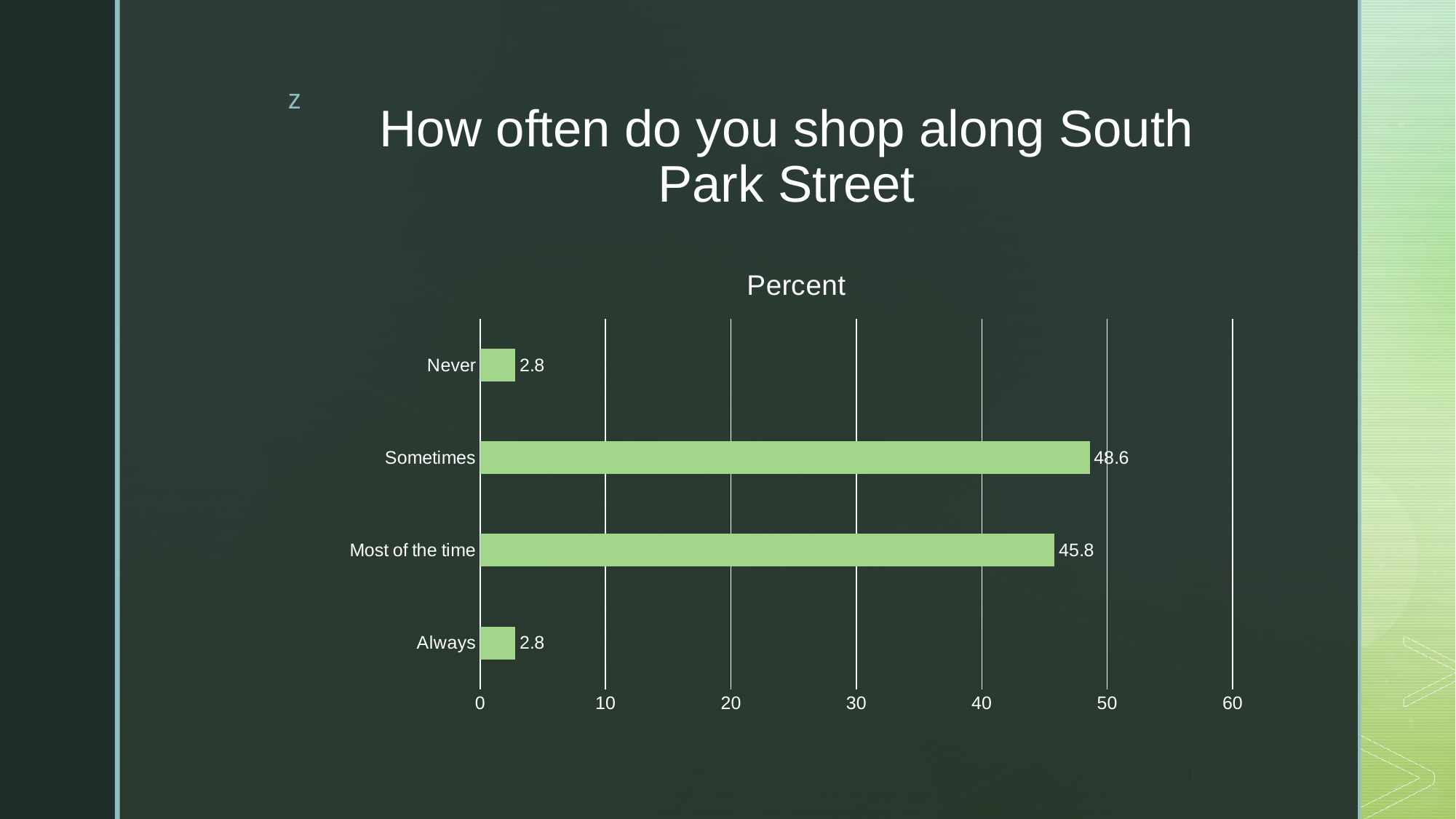
Is the value for Most of the time greater or less than 40? greater What kind of chart is shown on the slide? bar chart What is the value for Most of the time? 45.8 What is the value for Always? 2.8 Which is larger, the value for Sometimes or the value for Most of the time? Sometimes Which category has the highest value? Sometimes What is the value for Sometimes? 48.6 How many categories are shown in the chart? 4 What is the title of the chart? Percent What is the value for Never? 2.8 What is the difference between the values for Sometimes and Most of the time? 2.8 What is the difference between the values for Most of the time and Never? 43